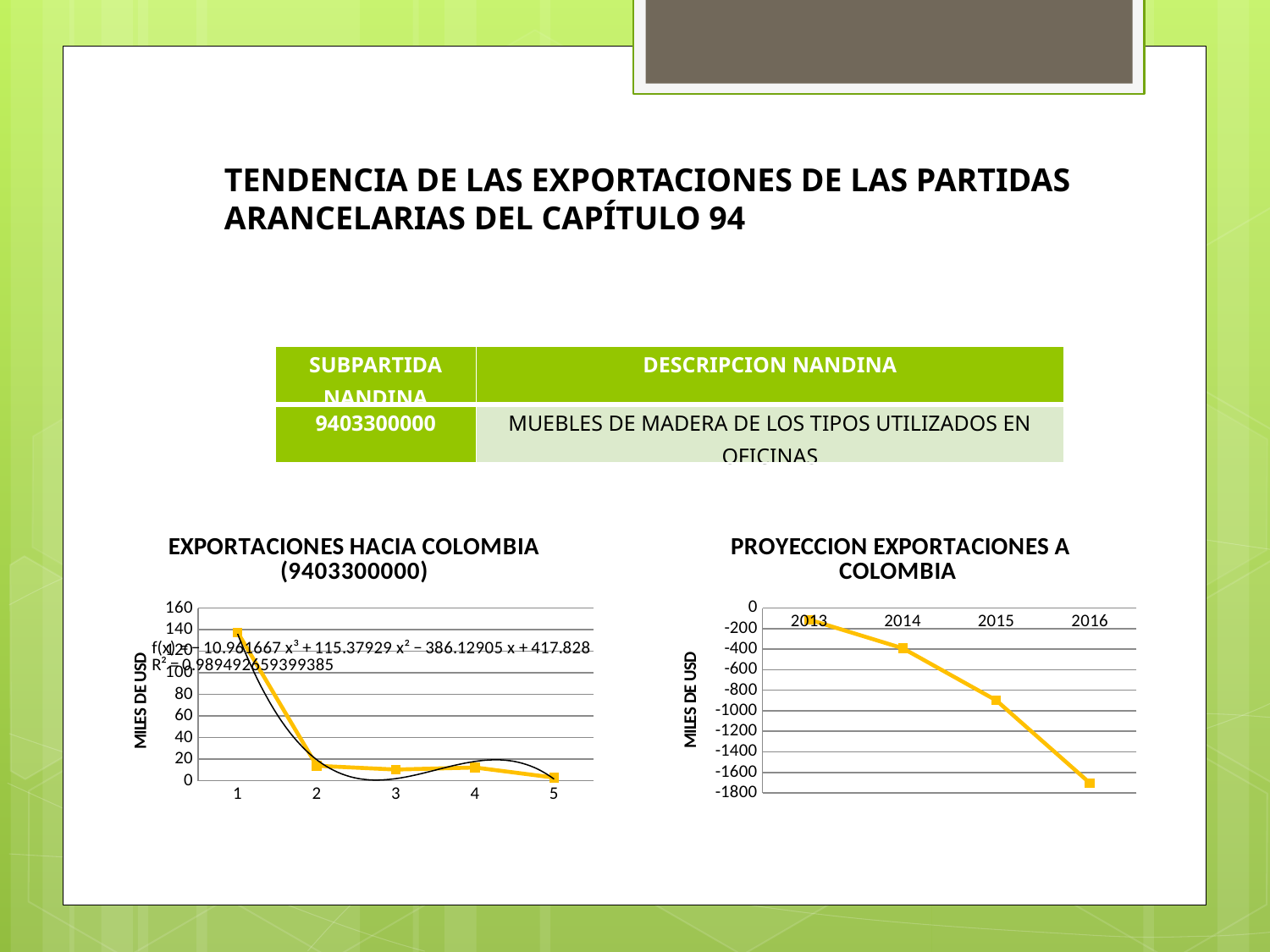
In the 'EXPORTACIONES HACIA COLOMBIA (9403300000)' chart, which x-axis point has the highest value? 1 In the 'PROYECCION EXPORTACIONES A COLOMBIA' chart, is the value for 2016 greater or less than -1400? less In the 'PROYECCION EXPORTACIONES A COLOMBIA' chart, which year has the larger value, 2014 or 2015? 2014 How many years are shown on the x axis of the 'PROYECCION EXPORTACIONES A COLOMBIA' chart? 4 In the 'PROYECCION EXPORTACIONES A COLOMBIA' chart, do the values rise or fall from 2013 to 2016? fall What is the y-axis label of the 'PROYECCION EXPORTACIONES A COLOMBIA' chart? MILES DE USD What kind of chart is the 'PROYECCION EXPORTACIONES A COLOMBIA' chart? line chart In the 'EXPORTACIONES HACIA COLOMBIA (9403300000)' chart, which point has the larger value, point 1 or point 2? 1 What kind of chart is the 'EXPORTACIONES HACIA COLOMBIA (9403300000)' chart? line chart In the 'PROYECCION EXPORTACIONES A COLOMBIA' chart, which year has the lowest value? 2016 How many data points are plotted in the 'EXPORTACIONES HACIA COLOMBIA (9403300000)' chart? 5 In the 'EXPORTACIONES HACIA COLOMBIA (9403300000)' chart, is the value at point 1 greater or less than 120? greater